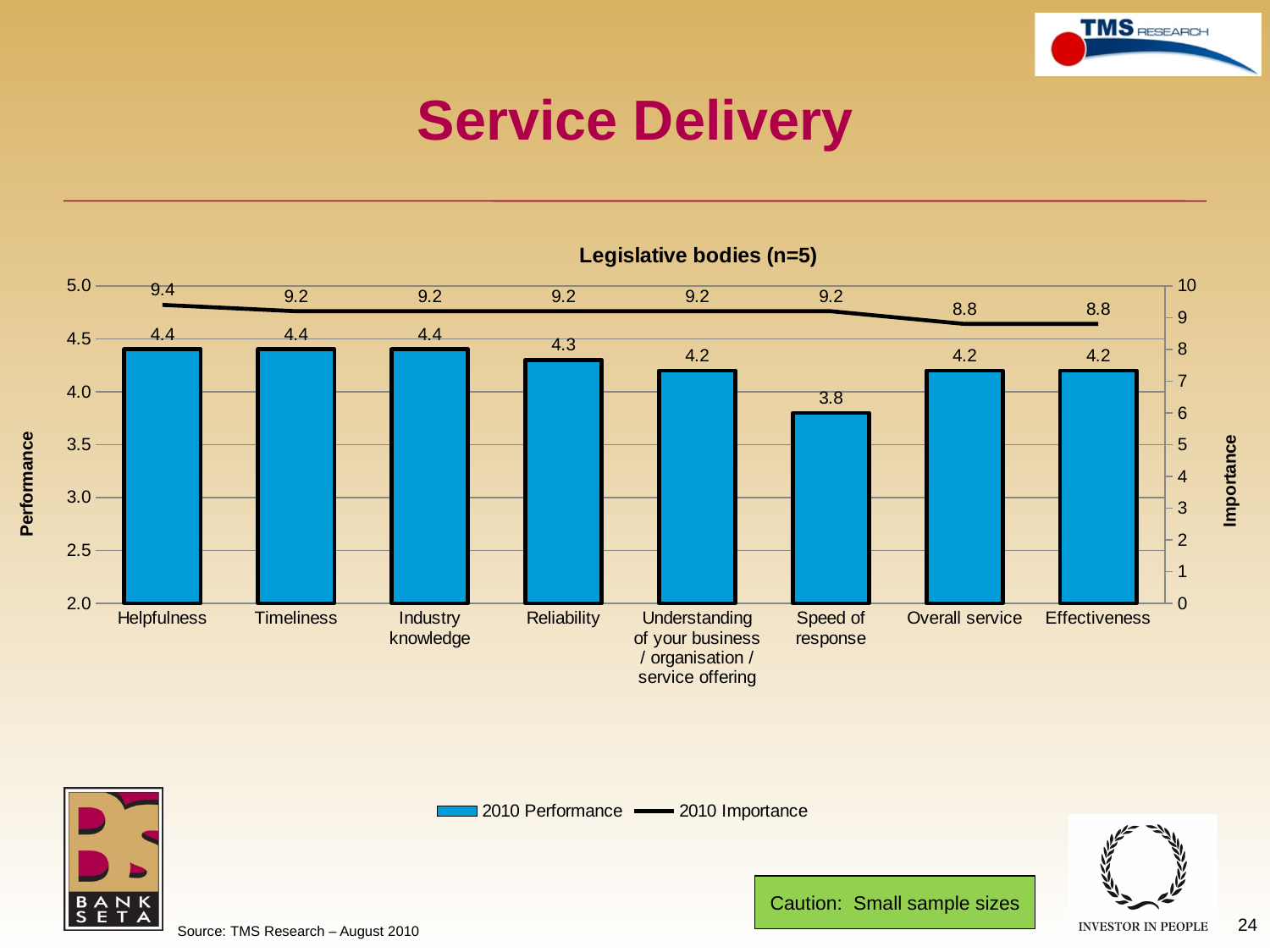
What is the 2010 Performance value for Reliability? 4.3 Which category has the lowest 2010 Performance value? Speed of response How many series does the legend list? 2 What is the difference between the 2010 Performance values for Helpfulness and Speed of response? 0.6 What is the 2010 Importance value for Helpfulness? 9.4 What is the 2010 Importance value for Effectiveness? 8.8 Which is larger, the 2010 Performance value for Reliability or for Overall service? Reliability Which category has the highest 2010 Importance value? Helpfulness What is the title of the chart? Legislative bodies (n=5) What kind of chart is used to show 2010 Performance? Bar chart How many categories are shown on the x axis? 8 What is the 2010 Performance value for Speed of response? 3.8